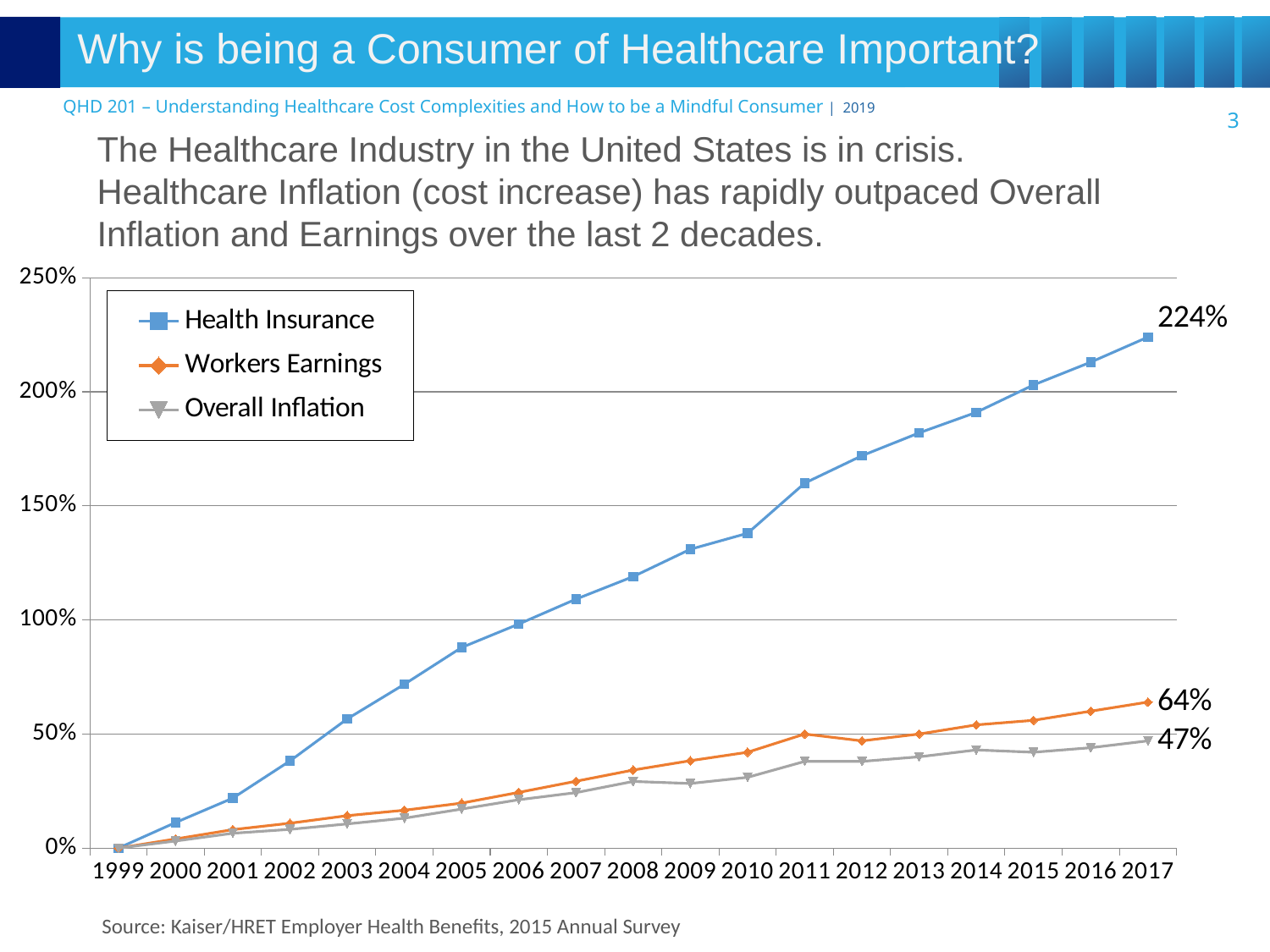
Which series has the highest value in 2017? Health Insurance Does the Health Insurance series rise or fall from 1999 to 2017? rise What is the value for Overall Inflation in 2017? 47% What is the value for Workers Earnings in 2017? 64% Is the value for Health Insurance in 2011 greater or less than 150%? greater What is the difference between the Health Insurance and Workers Earnings values in 2017? 160% How many years are shown on the x axis? 19 How many series does the legend list? 3 Which series has the lowest value in 2017? Overall Inflation Which is larger in 2017, Workers Earnings or Overall Inflation? Workers Earnings What is the value for Health Insurance in 2017? 224% What type of chart is shown on the slide? line chart